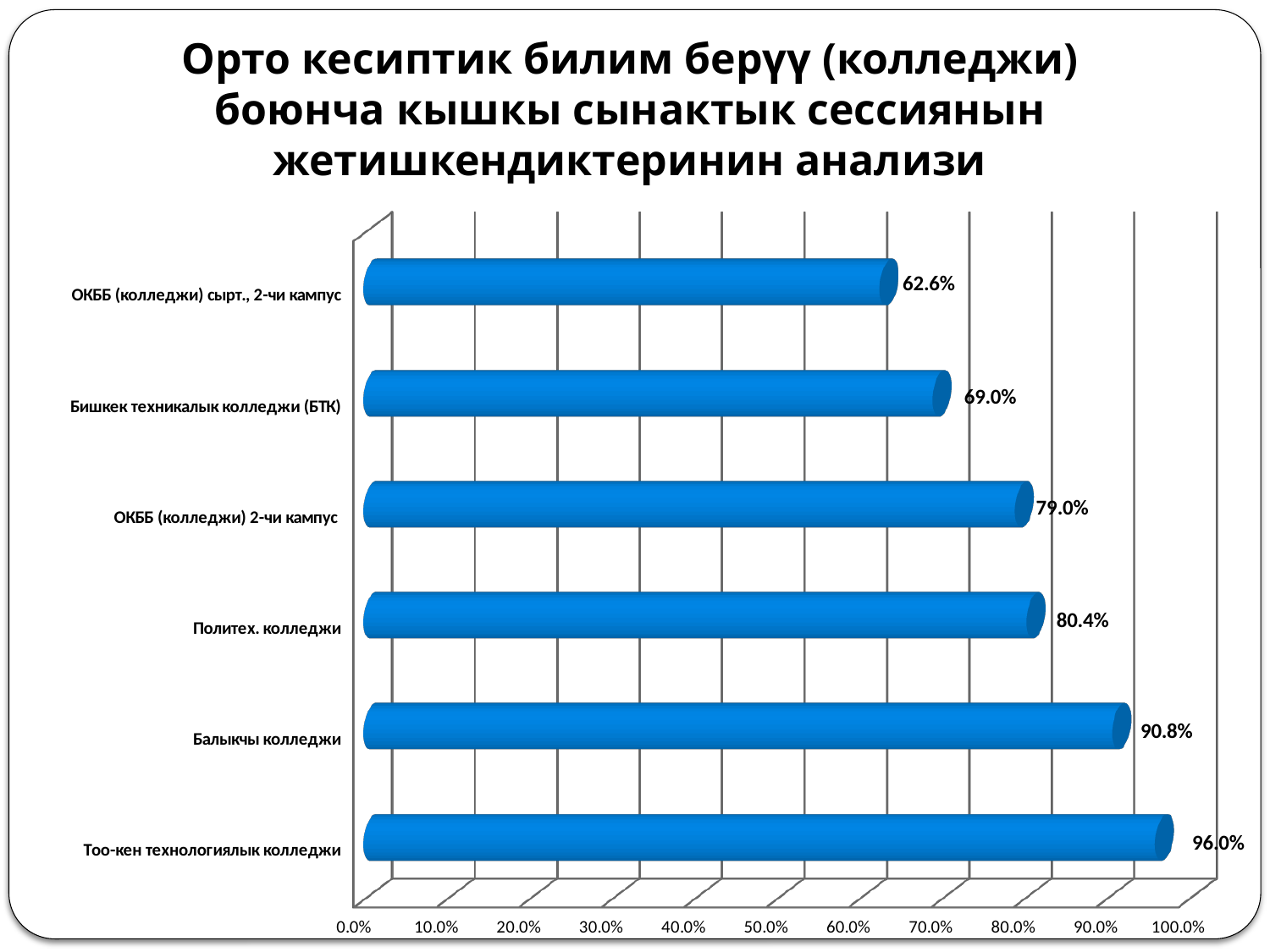
What is the value for Политех. колледжи? 80.4% How many categories are shown in the chart? 6 What is the value for Бишкек техникалык колледжи (БТК)? 69.0% Which category has the highest value? Тоо-кен технологиялык колледжи What kind of chart is shown on the slide? bar chart Is the value for Бишкек техникалык колледжи (БТК) greater or less than 60.0%? greater What is the difference between the values for ОКББ (колледжи) 2-чи кампус and ОКББ (колледжи) сырт., 2-чи кампус? 16.4% What is the value for Тоо-кен технологиялык колледжи? 96.0% What is the value for Балыкчы колледжи? 90.8% What is the difference between the values for Тоо-кен технологиялык колледжи and Балыкчы колледжи? 5.2% Which is larger, the value for Политех. колледжи or the value for ОКББ (колледжи) 2-чи кампус? Политех. колледжи Which category has the lowest value? ОКББ (колледжи) сырт., 2-чи кампус